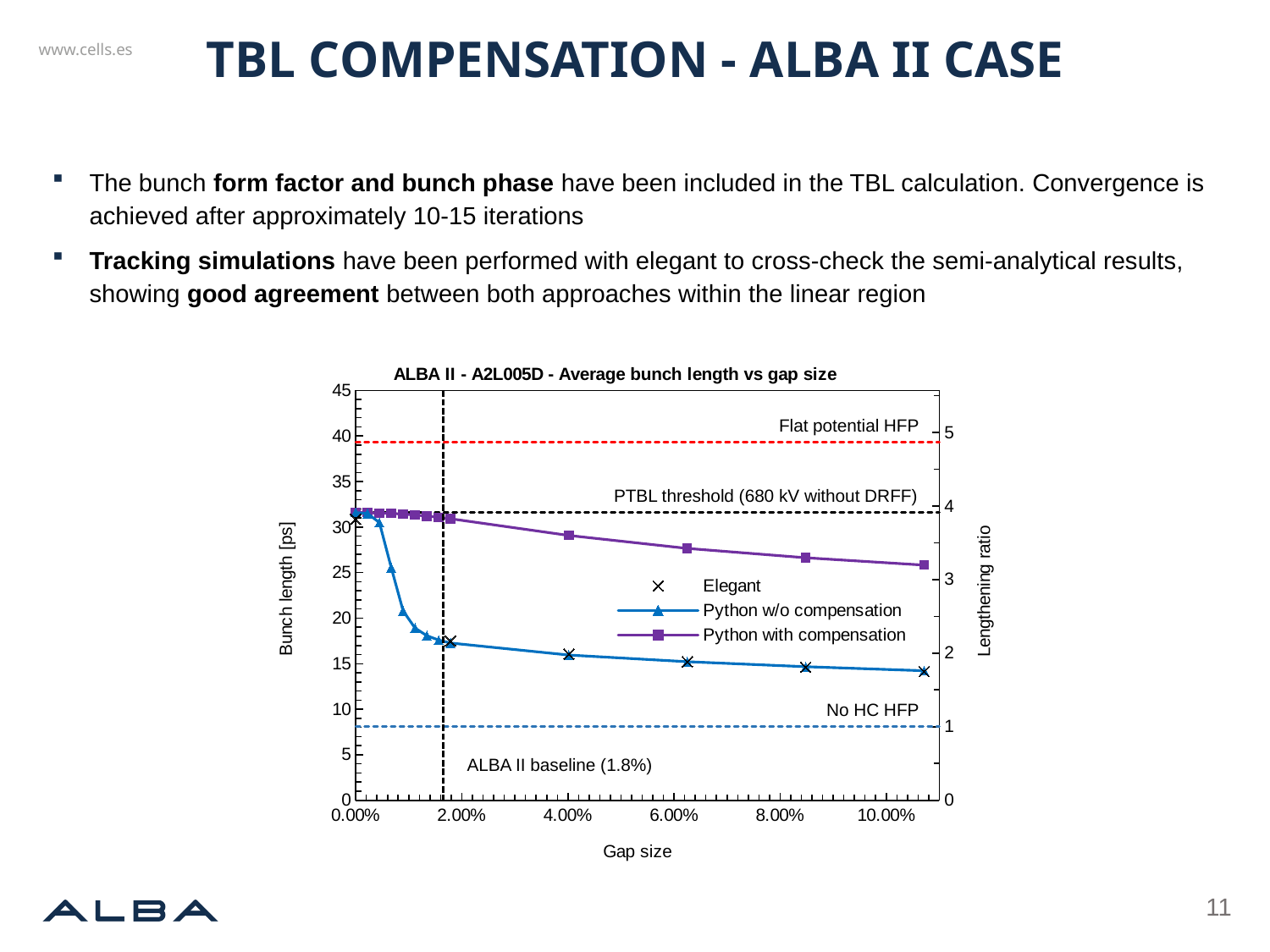
What kind of chart is shown on the slide? line chart Is the bunch length for 'Python w/o compensation' at a gap size of 4.00% greater or less than 20 ps? less What is the title of the chart? ALBA II - A2L005D - Average bunch length vs gap size Is the bunch length for 'Python with compensation' at a gap size of 4.00% greater or less than 25 ps? greater How many series does the chart legend list? 3 Is the bunch length for 'Python w/o compensation' at a gap size of 10.00% greater or less than 20 ps? less Does the bunch length for the 'Python w/o compensation' series rise or fall as gap size increases? fall At a gap size of 6.00%, which series has the larger bunch length: 'Python with compensation' or 'Python w/o compensation'? Python with compensation Which series in the chart is plotted with cross markers only? Elegant What is the label of the x axis of the chart? Gap size Does the bunch length for the 'Python with compensation' series rise or fall as gap size increases? fall